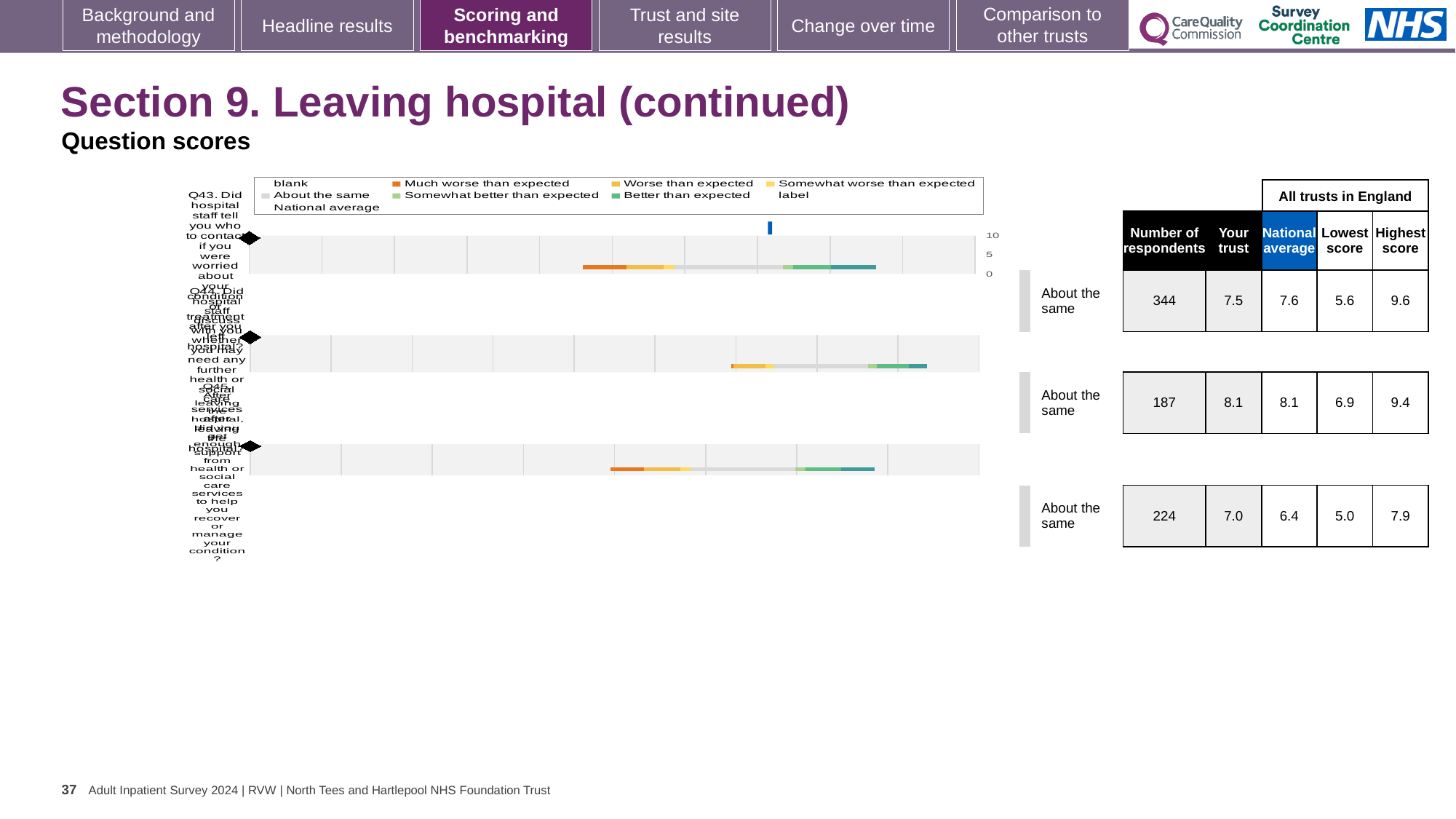
Which row of the chart has the lowest 'Your trust' score? the third row (7.0) For the top row (Q43), what is the difference between the highest score and the lowest score across all trusts in England? 4.0 How many question rows are plotted in the chart? 3 What is the 'Your trust' score for the top row (Q43)? 7.5 For the second row, what is the difference between the highest score (9.4) and the lowest score (6.9)? 2.5 What is the national average score for the top row (Q43)? 7.6 What kind of chart is used to show the question scores? bar chart For the third row, is the 'Your trust' score or the national average larger? Your trust (7.0) Which row of the chart has the highest 'Your trust' score? the second row (8.1) What benchmark category is shown beside each of the three rows? About the same What is the highest score across all trusts in England for the third row? 7.9 How many respondents are listed for the second row of the chart? 187